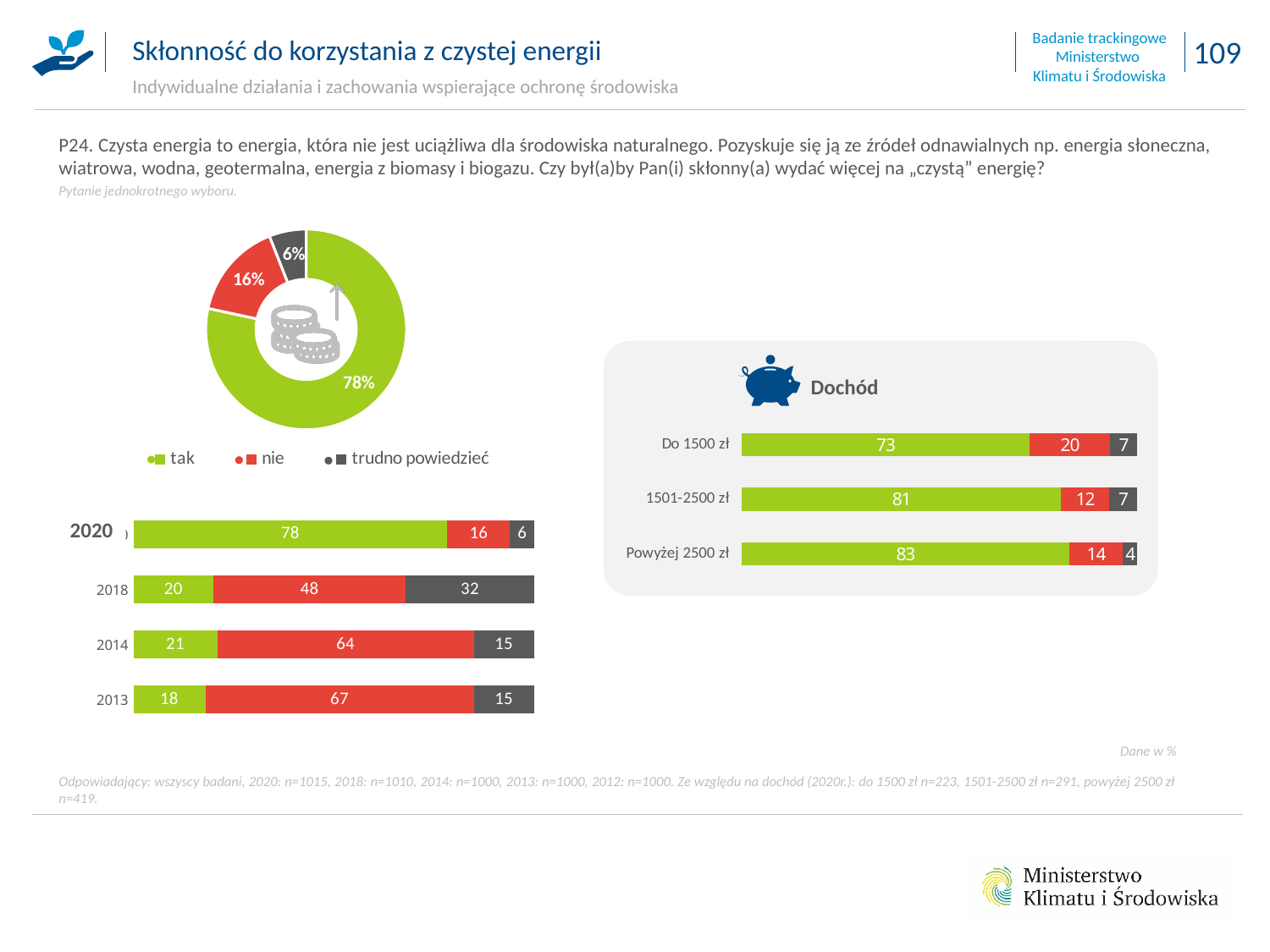
In the donut chart on the left, what share of respondents answered "trudno powiedzieć"? 6% In the donut chart on the left, what share of respondents answered "tak"? 78% In the stacked bar chart by year at the bottom left, what is the value of the "nie" segment for 2018? 48 In the "Dochód" chart on the right, is the "nie" value larger for "Do 1500 zł" or for "Powyżej 2500 zł"? Do 1500 zł In the "Dochód" chart on the right, which income group has the highest "tak" value? Powyżej 2500 zł In the stacked bar chart by year at the bottom left, which year has the lowest "tak" value? 2013 How many years are shown in the stacked bar chart at the bottom left? 4 In the "Dochód" chart on the right, what is the "tak" value for the "1501-2500 zł" group? 81 How many entries does the legend of the donut chart on the left list? 3 In the stacked bar chart by year at the bottom left, which year has the highest "tak" value? 2020 In the stacked bar chart by year at the bottom left, what is the difference between the "nie" values for 2013 and 2014? 3 What type of chart is the "Dochód" chart on the right? Stacked bar chart